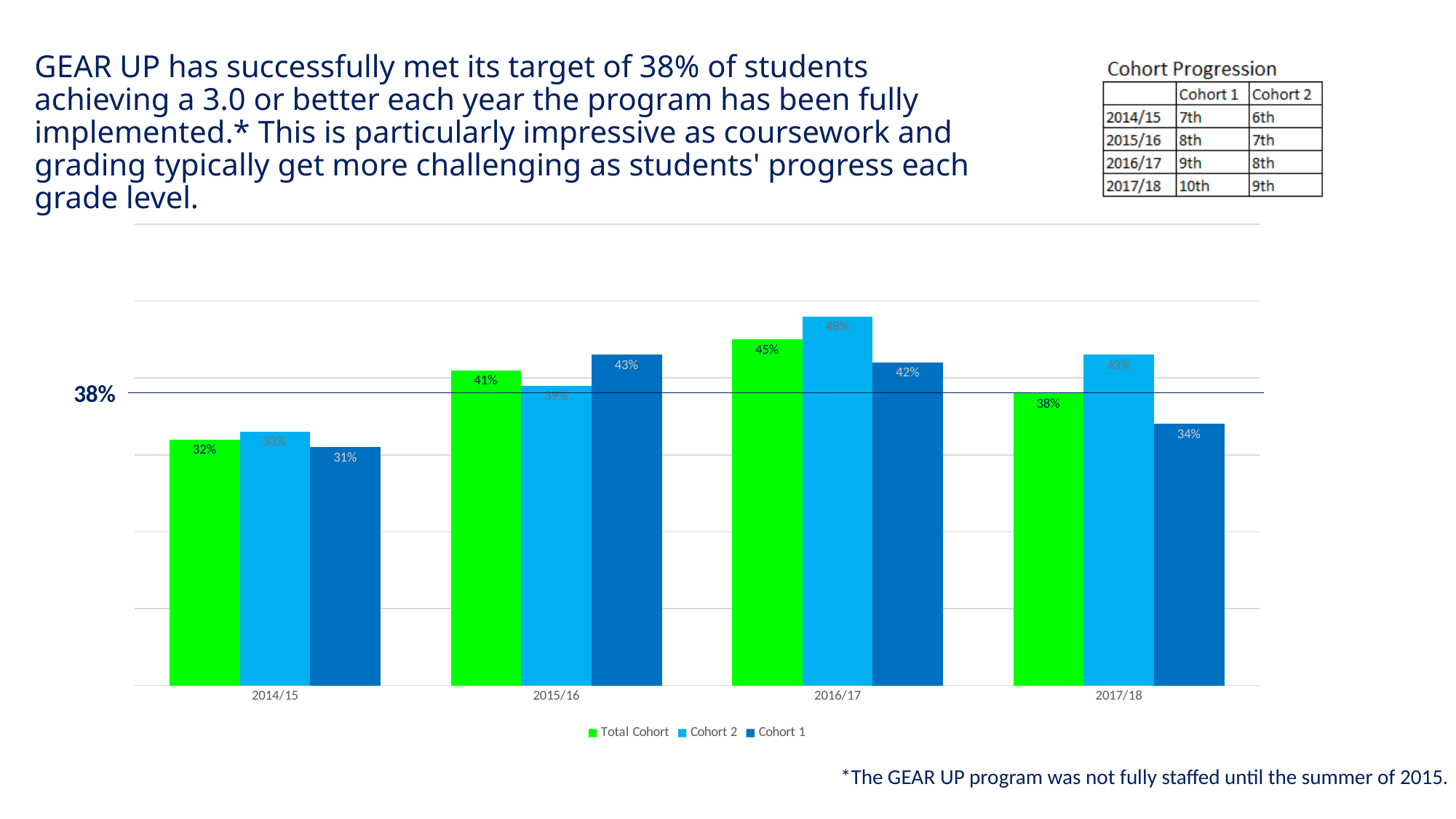
In which year is the Cohort 2 value highest? 2016/17 In which year is the Total Cohort value lowest? 2014/15 What value is marked by the horizontal reference line on the chart? 38% How many years are shown on the x axis? 4 What kind of chart is shown on the slide? Bar chart How many series does the legend list? 3 What is the Total Cohort value for 2016/17? 45% What is the Cohort 1 value for 2014/15? 31% Does the Cohort 1 value rise or fall from 2016/17 to 2017/18? Fall Which is larger in 2016/17, Cohort 2 or Cohort 1? Cohort 2 What is the Cohort 2 value for 2017/18? 43% What is the difference between the Cohort 1 value in 2015/16 and in 2017/18? 9%